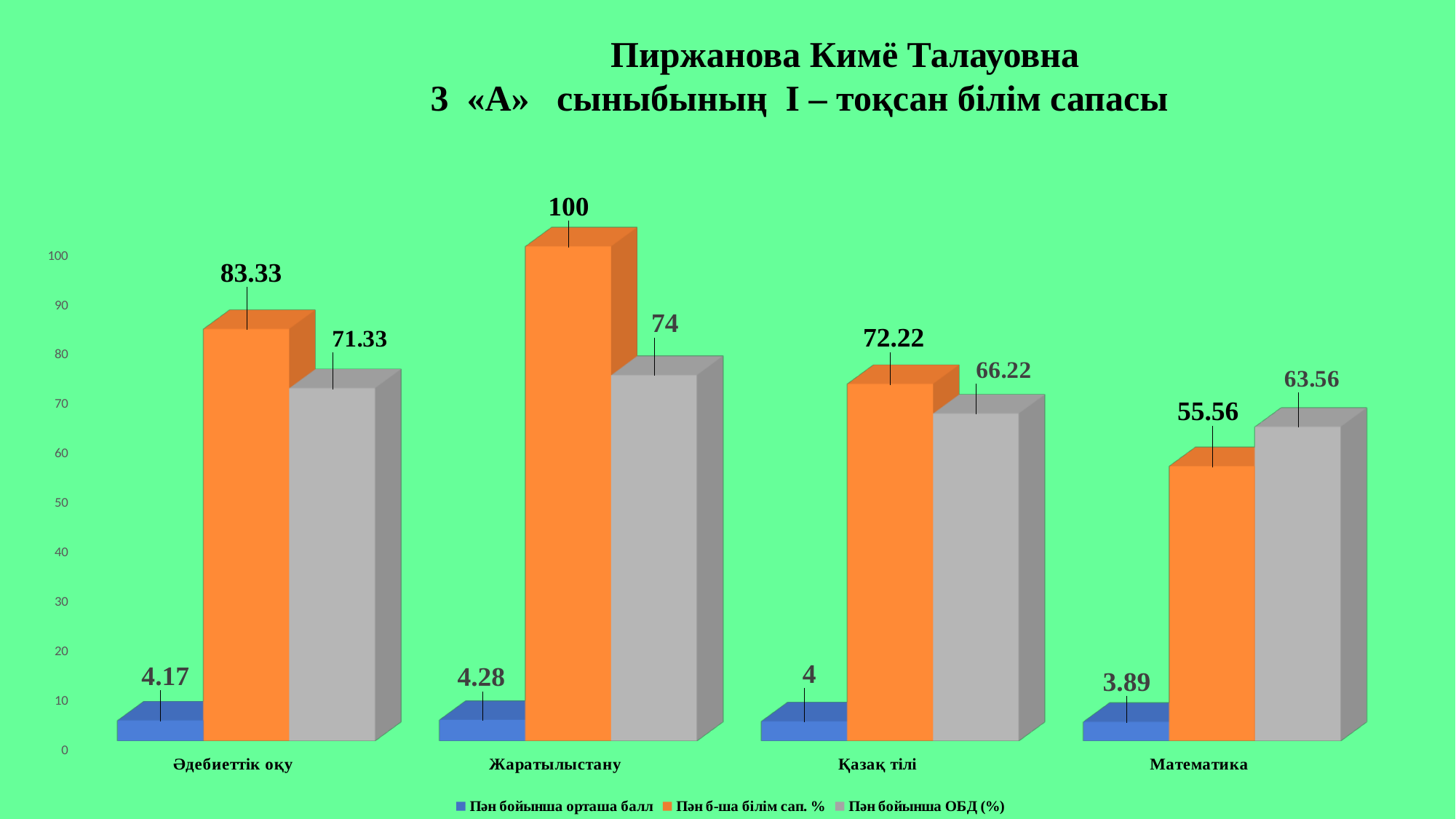
Which category has the lowest value for "Пән бойынша орташа балл"? Математика How many series does the legend list? 3 Which category has the highest value for "Пән б-ша білім сап. %"? Жаратылыстану What kind of chart is shown on the slide? bar chart Is the value of "Пән бойынша ОБД (%)" for Қазақ тілі greater or less than 70? less What is the value of "Пән б-ша білім сап. %" for Жаратылыстану? 100 What is the value of "Пән бойынша орташа балл" for Әдебиеттік оқу? 4.17 How many categories are shown on the x axis? 4 What is the difference between the "Пән б-ша білім сап. %" values for Әдебиеттік оқу and Математика? 27.77 What is the value of "Пән бойынша ОБД (%)" for Математика? 63.56 What colour are the bars for the series "Пән б-ша білім сап. %"? orange Which is larger for Математика: "Пән б-ша білім сап. %" or "Пән бойынша ОБД (%)"? Пән бойынша ОБД (%)